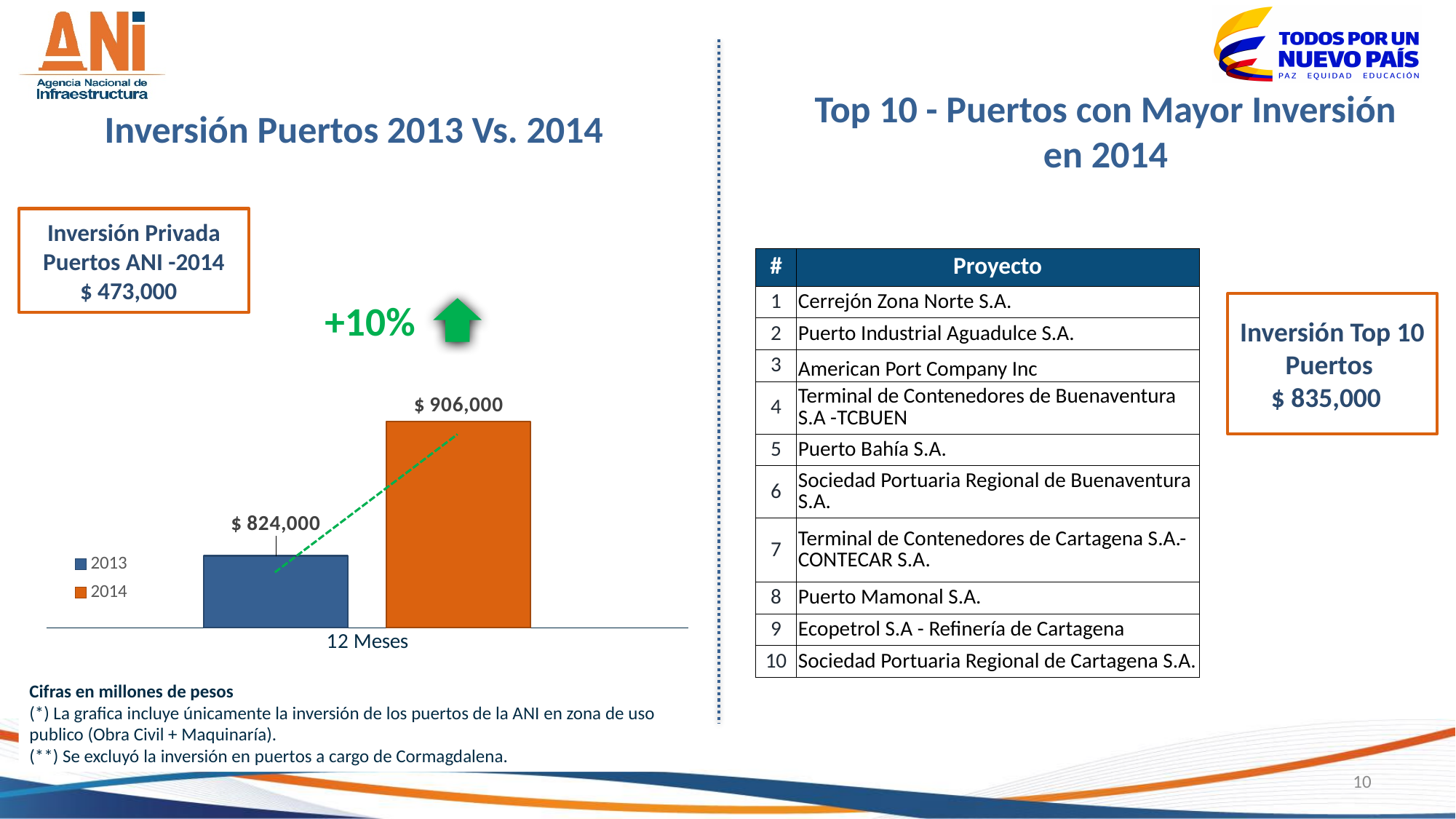
Which series has the highest value in the chart? 2014 How many series does the chart legend list? 2 What is the difference between the 2014 value and the 2013 value in the chart? $ 82,000 What is the value for 2013 in the chart? $ 824,000 How many bars are plotted in the chart? 2 What is the value for 2014 in the chart? $ 906,000 What kind of chart is shown on the slide? Bar chart What is the title of the chart on the left of the slide? Inversión Puertos 2013 Vs. 2014 Do the values in the chart rise or fall from 2013 to 2014? Rise What is the category label shown on the x axis of the chart? 12 Meses Which series has the higher value in the chart, 2013 or 2014? 2014 Which series has the lowest value in the chart? 2013